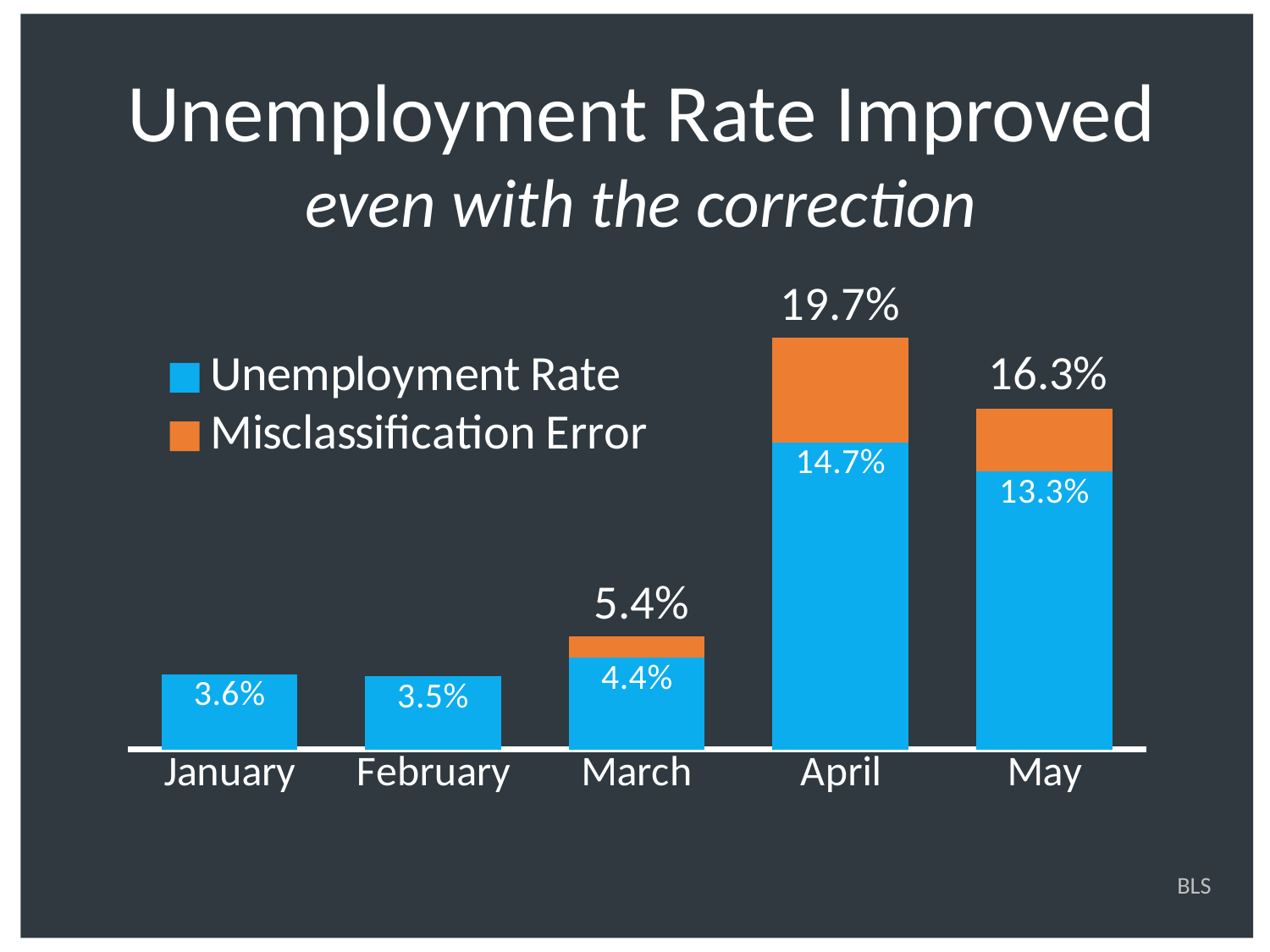
Is the Unemployment Rate higher in March or in February? March Which month has the lowest Unemployment Rate? February Which month has the highest Unemployment Rate? April What kind of chart is shown on the slide? Stacked bar chart What is the total height of the stacked bar for March? 5.4% What is the Unemployment Rate for April? 14.7% How many series does the legend list? 2 How many months are shown on the x axis? 5 What is the total height of the stacked bar for May? 16.3% What is the difference between the total bar for April (19.7%) and its Unemployment Rate (14.7%)? 5.0% What is the difference between the Unemployment Rate in April and in May? 1.4% What is the Unemployment Rate for January? 3.6%